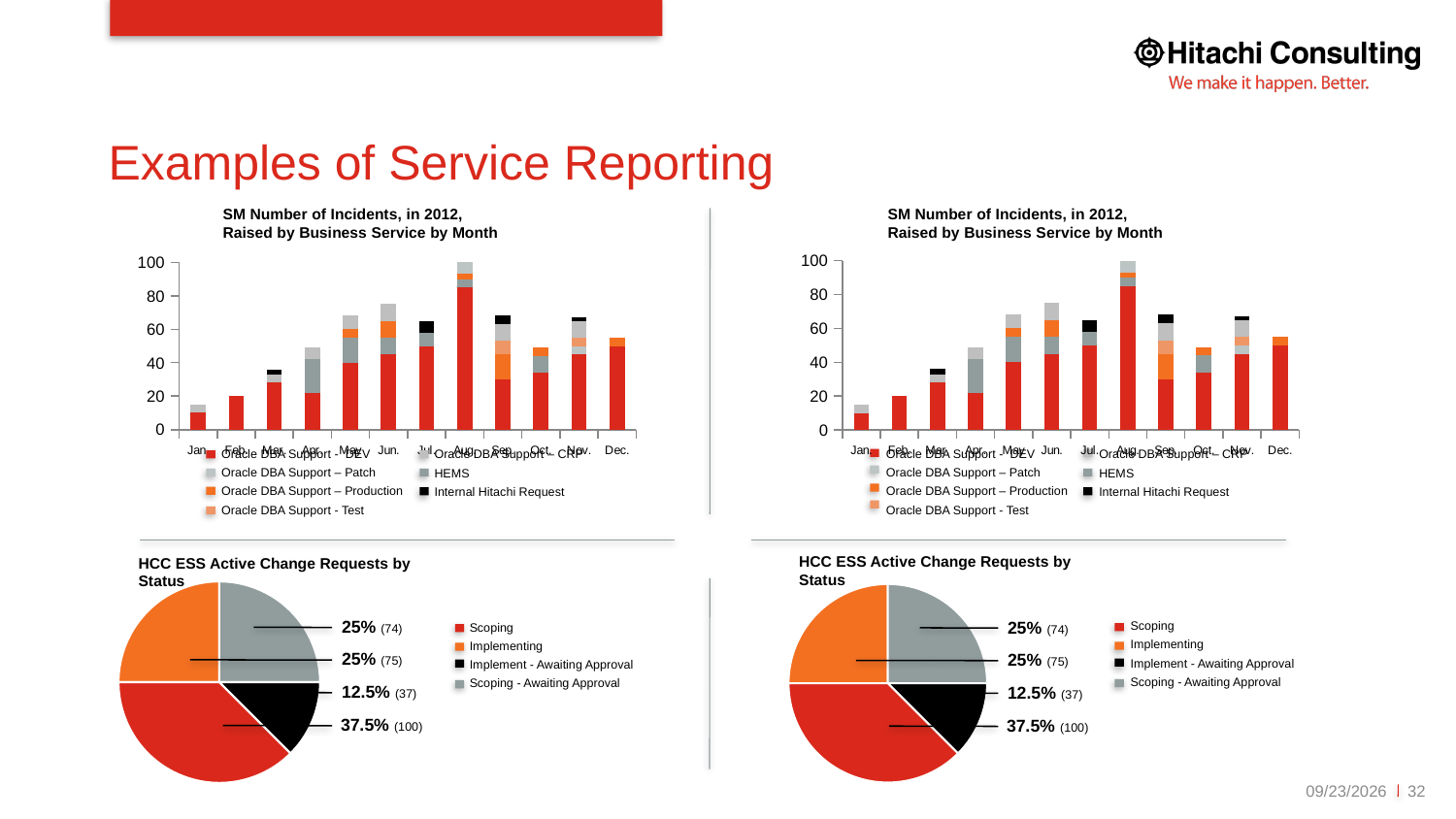
What kind of chart is the top-left chart titled 'SM Number of Incidents, in 2012, Raised by Business Service by Month'? Stacked bar chart In the top-left bar chart, is the total for Aug. greater or less than 80? greater In the top-right bar chart, which month has the lowest total number of incidents? Jan. In the top-right bar chart, how many series does the legend list? 7 In the top-left bar chart, which month has the highest total number of incidents? Aug. In the bottom-right pie chart, how many change requests are in the 'Implement - Awaiting Approval' status? 37 What kind of chart is the bottom-left chart titled 'HCC ESS Active Change Requests by Status'? Pie chart In the bottom-left pie chart, what share of active change requests is in the Scoping status? 37.5% In the top-left bar chart, how many months are shown on the x axis? 12 In the bottom-right pie chart, how many slices does the pie have? 4 In the top-right bar chart, is the total for Jan. greater or less than 20? less In the top-left bar chart, which month has a larger total: Jun. or Mar.? Jun.